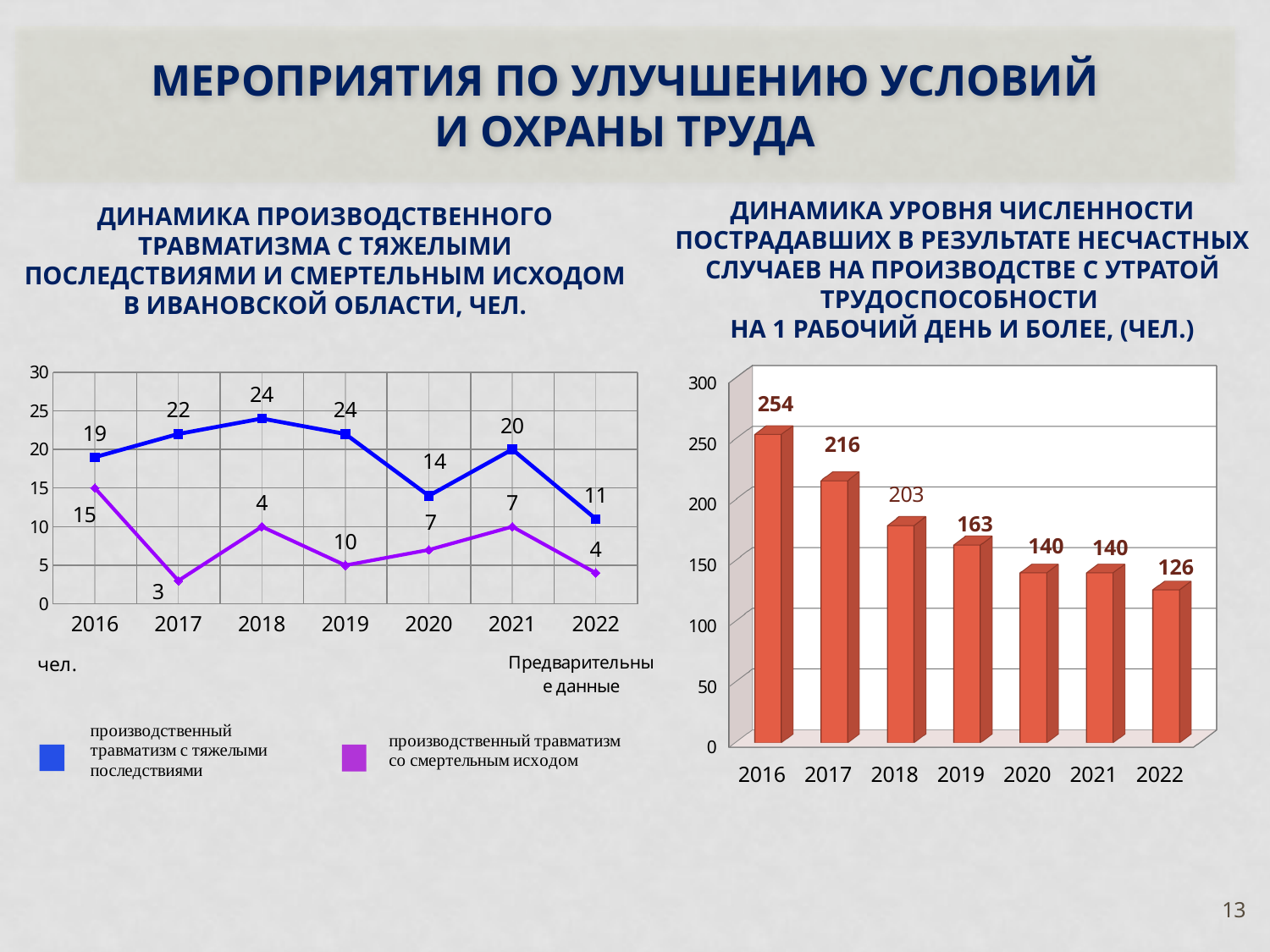
In the right chart (Динамика уровня численности пострадавших), which year has the lowest value? 2022 How many years are shown on the x axis of the left chart (Динамика производственного травматизма)? 7 What kind of chart is the right chart (Динамика уровня численности пострадавших)? bar chart In the right chart (Динамика уровня численности пострадавших), what is the value for 2016? 254 In the left chart (Динамика производственного травматизма), what is the value for производственный травматизм со смертельным исходом in 2016? 15 In the left chart (Динамика производственного травматизма), what is the value for производственный травматизм с тяжелыми последствиями in 2018? 24 In the left chart (Динамика производственного травматизма), which is larger in 2020: производственный травматизм с тяжелыми последствиями or производственный травматизм со смертельным исходом? производственный травматизм с тяжелыми последствиями In the right chart (Динамика уровня численности пострадавших), what is the value for 2022? 126 In the right chart (Динамика уровня численности пострадавших), which year has the highest value? 2016 In the right chart (Динамика уровня численности пострадавших), do the values generally rise or fall from 2016 to 2022? fall How many series does the legend of the left chart (Динамика производственного травматизма) list? 2 In the right chart (Динамика уровня численности пострадавших), what is the difference between the values for 2016 and 2017? 38